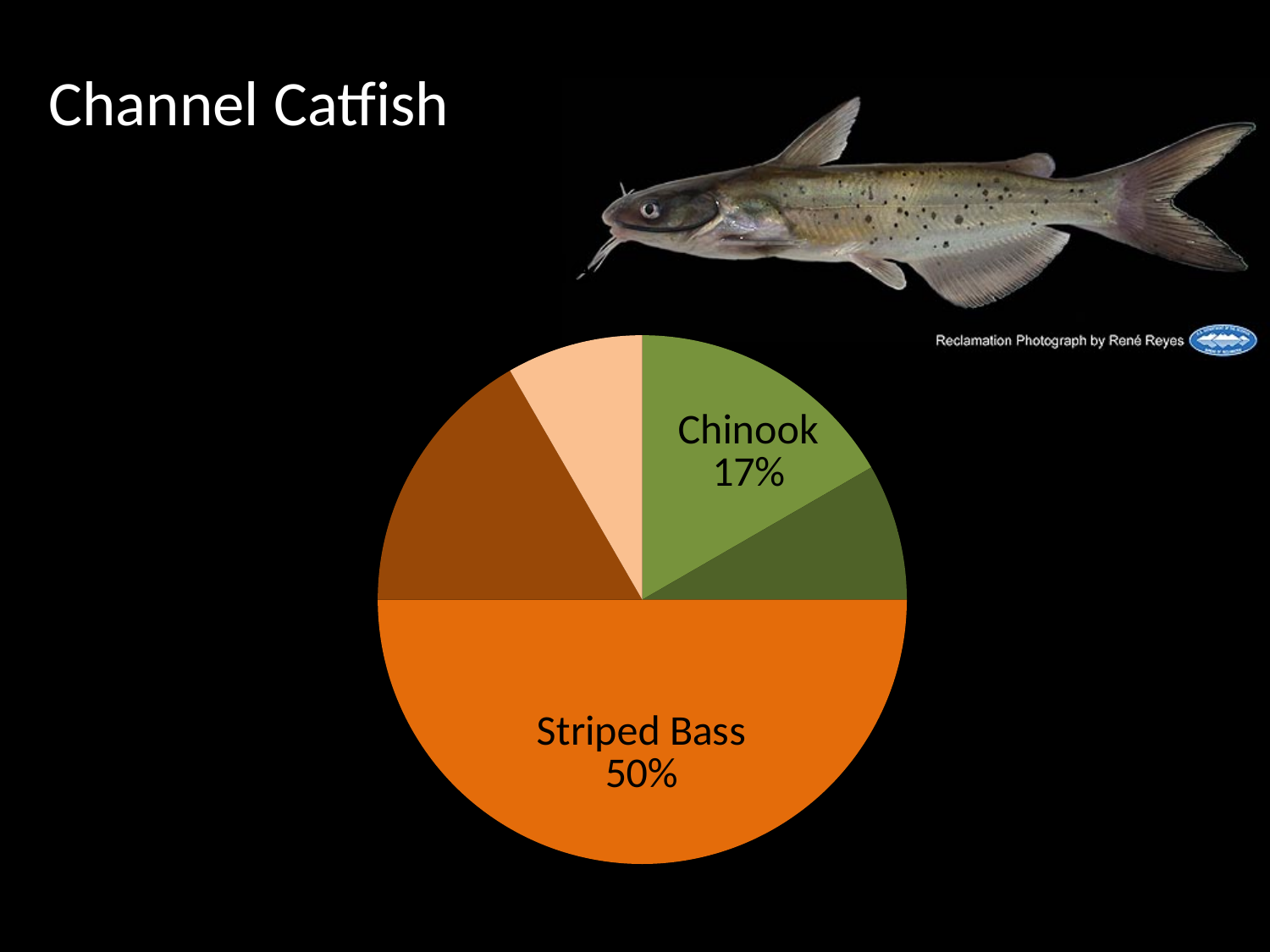
What colour is the Striped Bass slice of the pie? orange How many slices does the pie chart have? 5 Which is larger, the Striped Bass slice or the Chinook slice? Striped Bass What kind of chart is shown on the slide? pie chart What share of the pie does Striped Bass take up? 50% What is the title of the slide containing the pie chart? Channel Catfish Which labelled slice of the pie is the largest? Striped Bass What percentage of the pie is labelled Chinook? 17% By how many percentage points does the Striped Bass share exceed the Chinook share? 33 percentage points What percentage of the pie is labelled Striped Bass? 50%